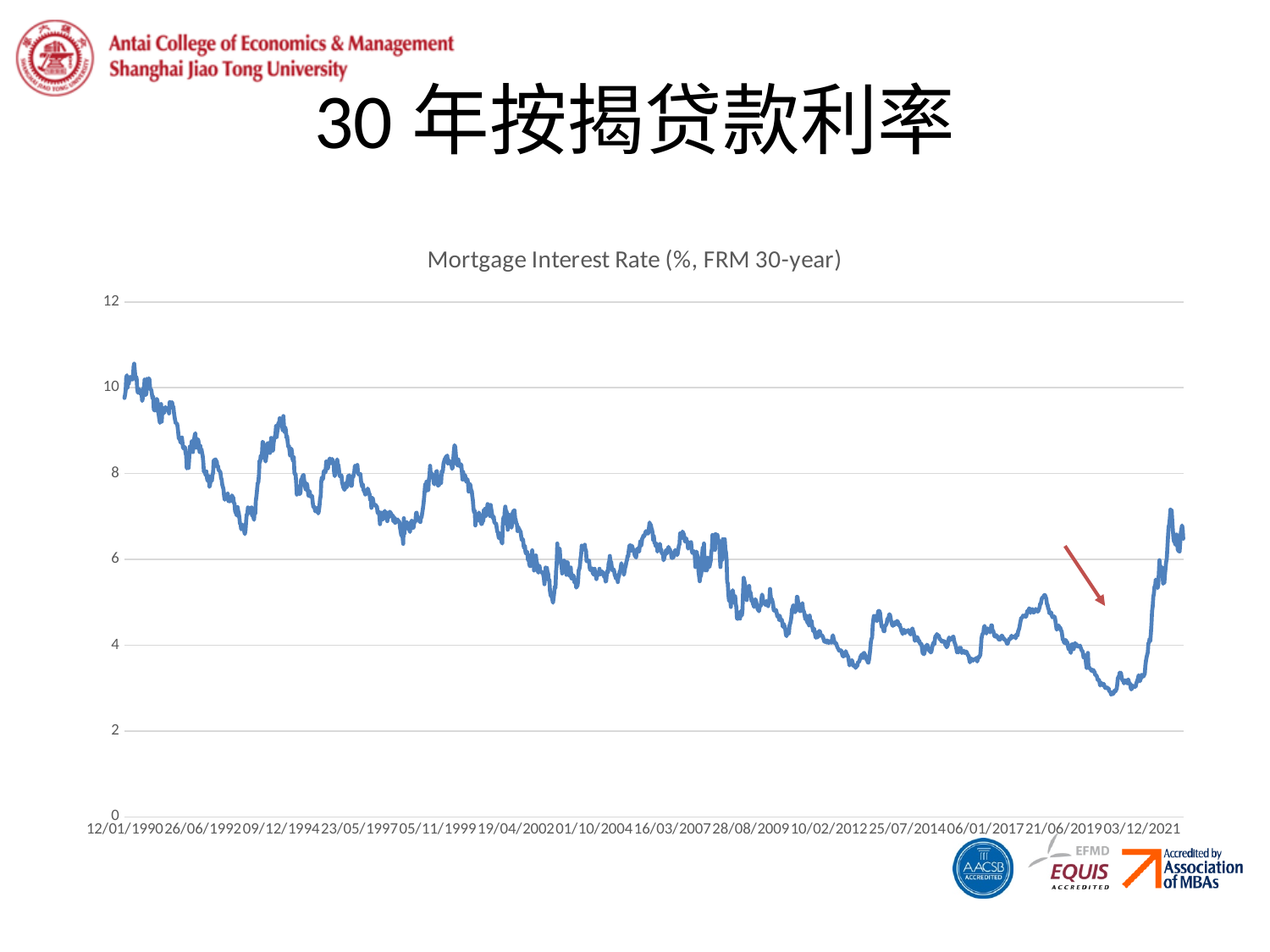
Is the mortgage interest rate at 06/01/2017 greater or less than 6? less Is the mortgage interest rate at 12/01/1990 greater or less than 8? greater Is the mortgage interest rate at 10/02/2012 greater or less than 6? less Which is higher, the mortgage interest rate at 12/01/1990 or at 03/12/2021? 12/01/1990 What is the title of the chart? Mortgage Interest Rate (%, FRM 30-year) What is the highest value shown on the y axis? 12 Overall, does the mortgage interest rate rise or fall from 1990 to 2021 along the x axis? fall How many date labels are shown on the x axis? 14 What kind of chart is shown on the slide? line chart